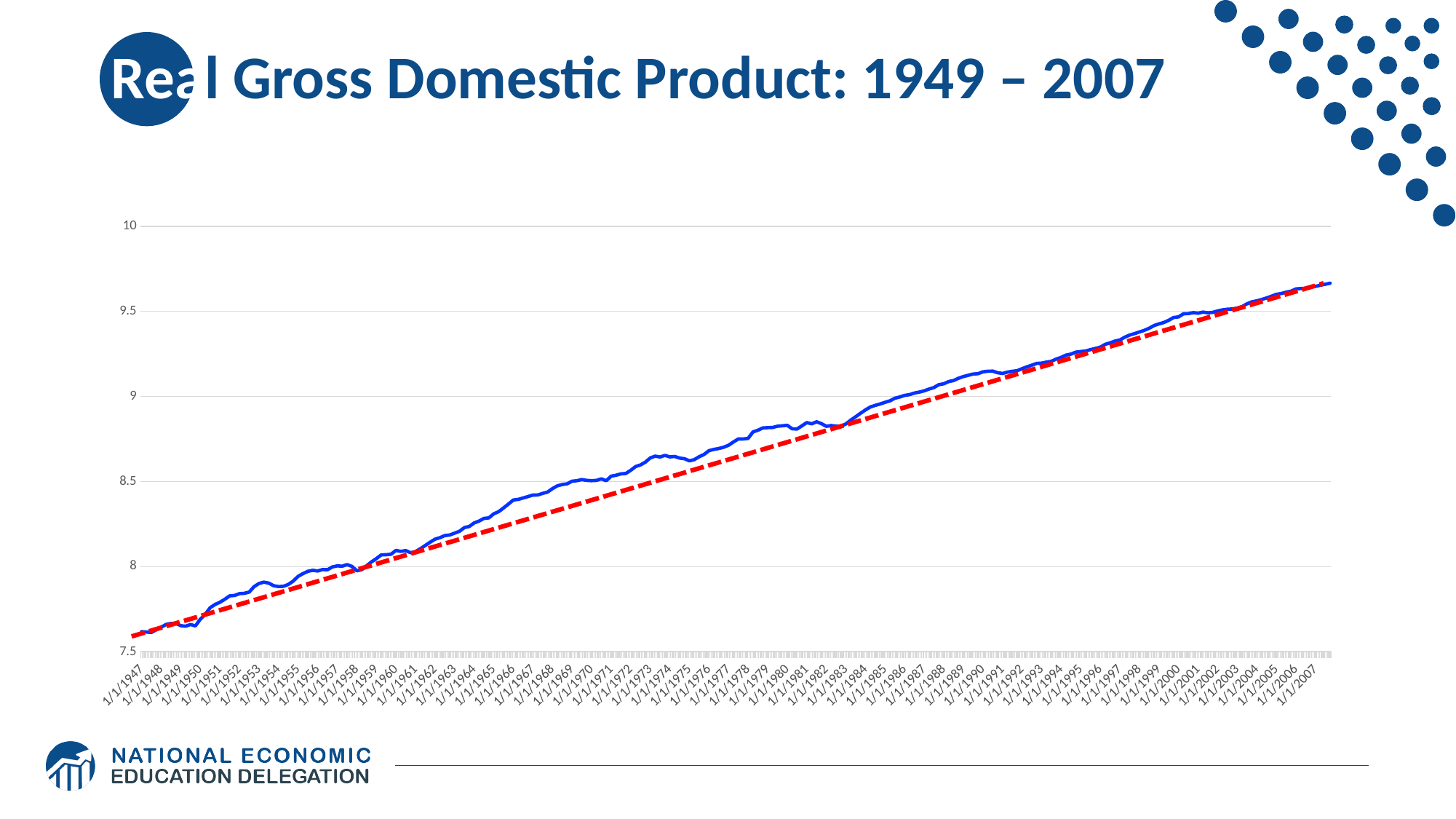
At which x-axis date does the blue line reach its highest value? 1/1/2007 Do the values of the blue line generally rise or fall from left to right along the x axis? rise Is the value of the blue line at 1/1/1990 greater or less than 9? greater Which is larger, the blue line's value at 1/1/2000 or at 1/1/1960? 1/1/2000 What is the title of the slide's chart? Real Gross Domestic Product: 1949 – 2007 Is the value of the blue line at 1/1/1947 greater or less than 8? less Is the value of the blue line at 1/1/2007 greater or less than 9.5? greater What kind of chart is shown on the slide? line chart What is the highest value shown on the y axis? 10 At which x-axis date does the blue line have its lowest value? 1/1/1947